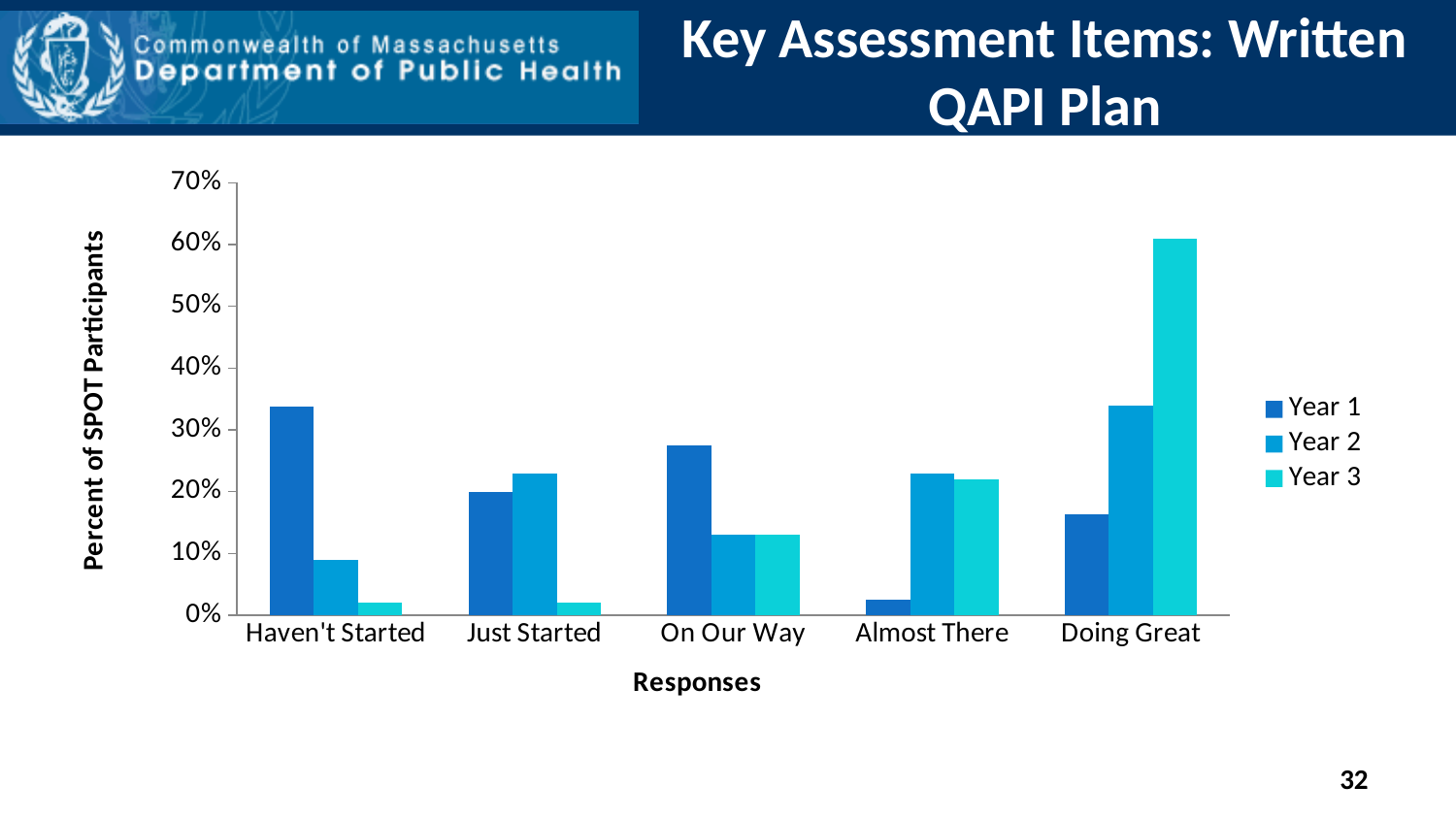
How many series does the legend list? 3 What is the title of the vertical axis? Percent of SPOT Participants For Haven't Started, which is larger: Year 1 or Year 2? Year 1 For Year 3, which response category has the highest value? Doing Great For Year 1, which response category has the highest value? Haven't Started Is the Year 1 value for Haven't Started greater or less than 30%? greater What kind of chart is shown on the slide? Bar chart For Doing Great, which is larger: Year 2 or Year 3? Year 3 For Year 1, which response category has the lowest value? Almost There Is the Year 3 value for Doing Great greater or less than 50%? greater How many response categories are shown on the x axis? 5 Do the Year 3 values rise or fall moving from Haven't Started to Doing Great along the x axis? rise